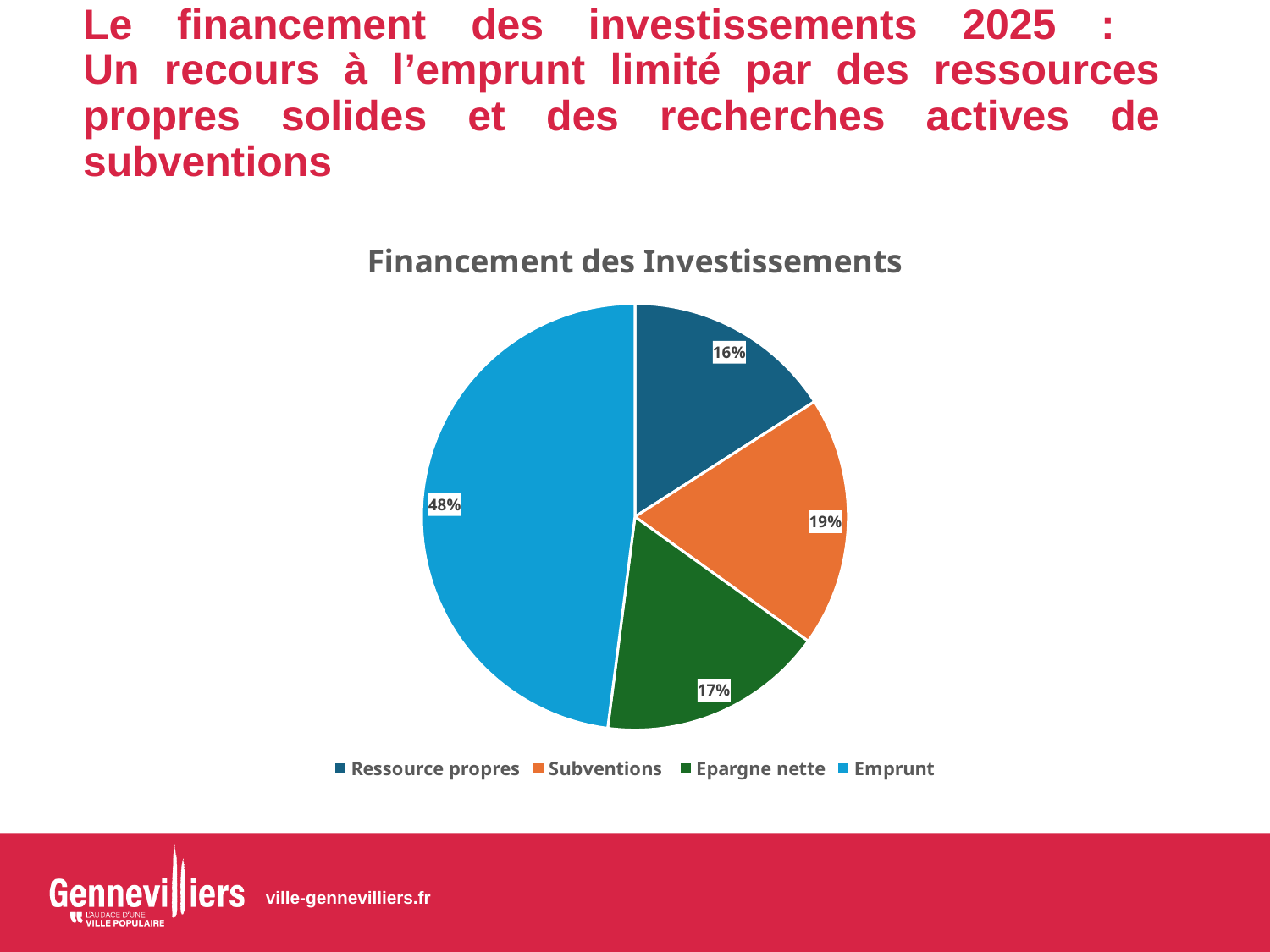
What is the value shown for Ressource propres? 16% What is the value shown for Subventions? 19% Which is larger, Subventions or Epargne nette? Subventions What is the value shown for Epargne nette? 17% How many categories are shown in the pie chart? 4 Which category has the smallest slice of the pie? Ressource propres Which category has the largest slice of the pie? Emprunt What is the difference in percentage points between Emprunt and Subventions? 29 What colour is the Emprunt slice? Light blue What is the title of the chart? Financement des Investissements What share of the pie does Emprunt represent? 48% What type of chart is shown on the slide? Pie chart